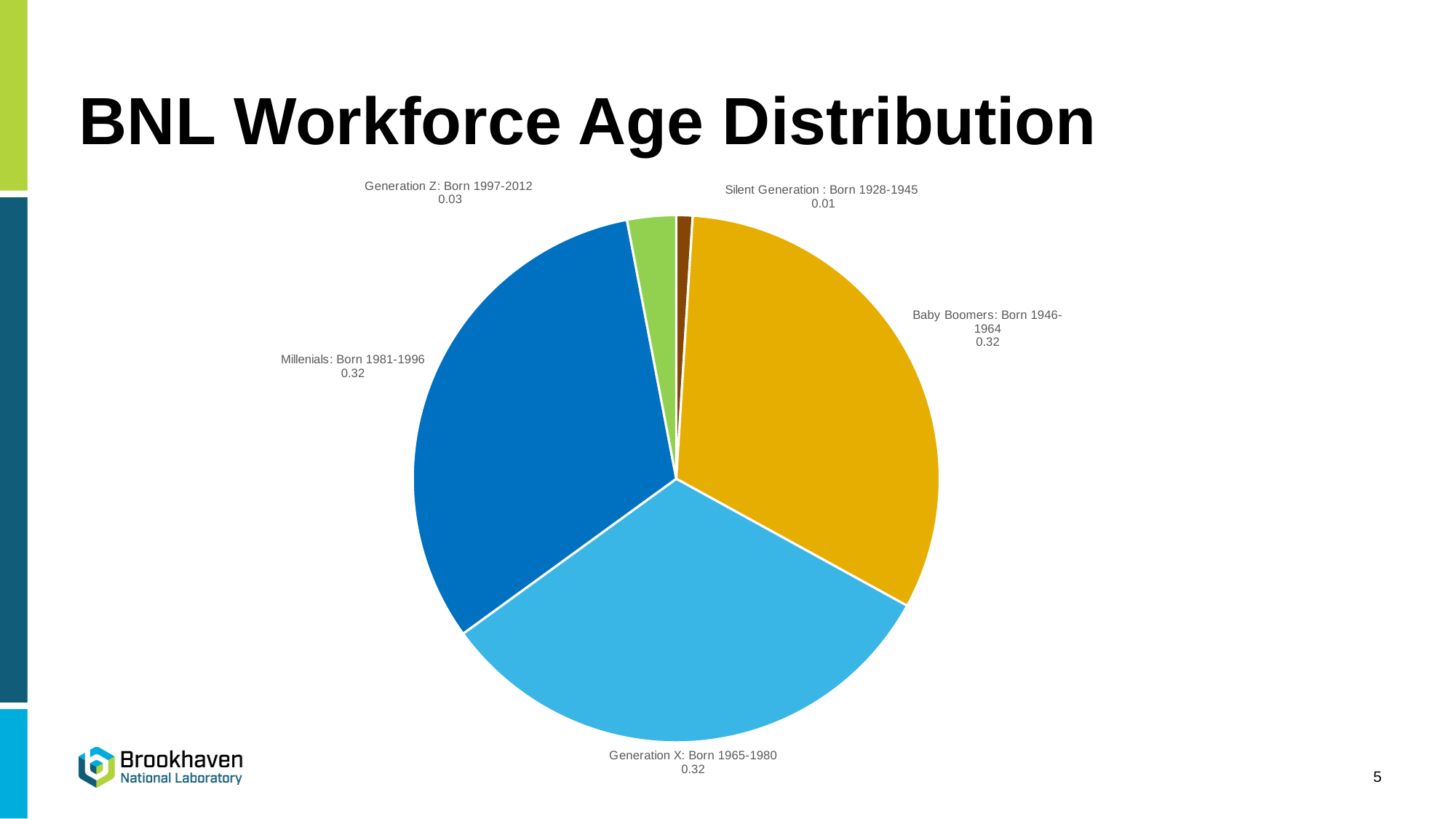
What colour is the slice for Baby Boomers: Born 1946-1964? yellow How many slices does the pie chart have? 5 What is the value shown for Baby Boomers: Born 1946-1964? 0.32 What is the value shown for Generation Z: Born 1997-2012? 0.03 What kind of chart is shown on the slide? pie chart What is the title of the slide containing the pie chart? BNL Workforce Age Distribution What is the value shown for Generation X: Born 1965-1980? 0.32 What is the value shown for Silent Generation: Born 1928-1945? 0.01 Which is larger, the slice for Generation Z or the slice for the Silent Generation? Generation Z What is the difference between the value for Millenials: Born 1981-1996 and the value for Generation Z: Born 1997-2012? 0.29 What share of the pie does Millenials: Born 1981-1996 represent? 0.32 Which generation has the smallest slice of the pie? Silent Generation : Born 1928-1945